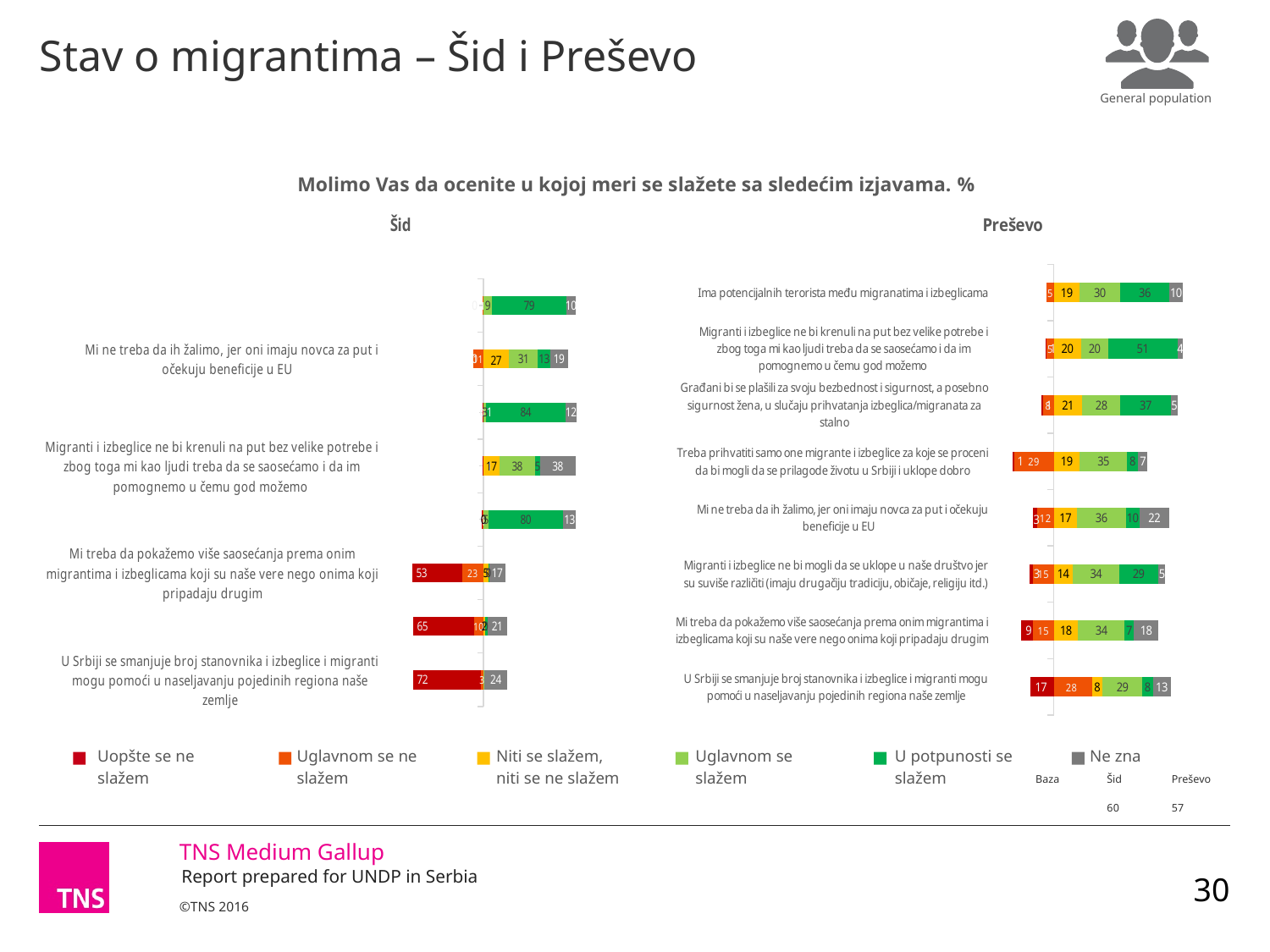
In the Preševo chart, what is the 'Ne zna' value for 'Mi ne treba da ih žalimo, jer oni imaju novca za put i očekuju beneficije u EU'? 22 In the Šid chart, what is the 'Uopšte se ne slažem' value for 'U Srbiji se smanjuje broj stanovnika i izbeglice i migranti mogu pomoći u naseljavanju pojedinih regiona naše zemlje'? 72 In the Preševo chart, what is the 'Uglavnom se ne slažem' value for 'U Srbiji se smanjuje broj stanovnika i izbeglice i migranti mogu pomoći...'? 28 In the Preševo chart, which statement has the highest 'U potpunosti se slažem' value? Migranti i izbeglice ne bi krenuli na put bez velike potrebe i zbog toga mi kao ljudi treba da se saosećamo i da im pomognemo u čemu god možemo In the Preševo chart, what is the 'Uglavnom se slažem' value for 'Ima potencijalnih terorista među migrantima i izbeglicama'? 30 How many statements (bars) are shown in the Preševo chart? 8 In the Šid chart, what is the 'Uopšte se ne slažem' value for 'Mi treba da pokažemo više saosećanja prema onim migrantima i izbeglicama koji su naše vere nego onima koji pripadaju drugim'? 53 What is the base (Baza) for Šid and for Preševo? Šid 60, Preševo 57 How many series does the legend list? 6 In the Preševo chart, what is the 'U potpunosti se slažem' value for 'Migranti i izbeglice ne bi krenuli na put bez velike potrebe...'? 51 What kind of chart is used for the Preševo data on this slide? Stacked bar chart